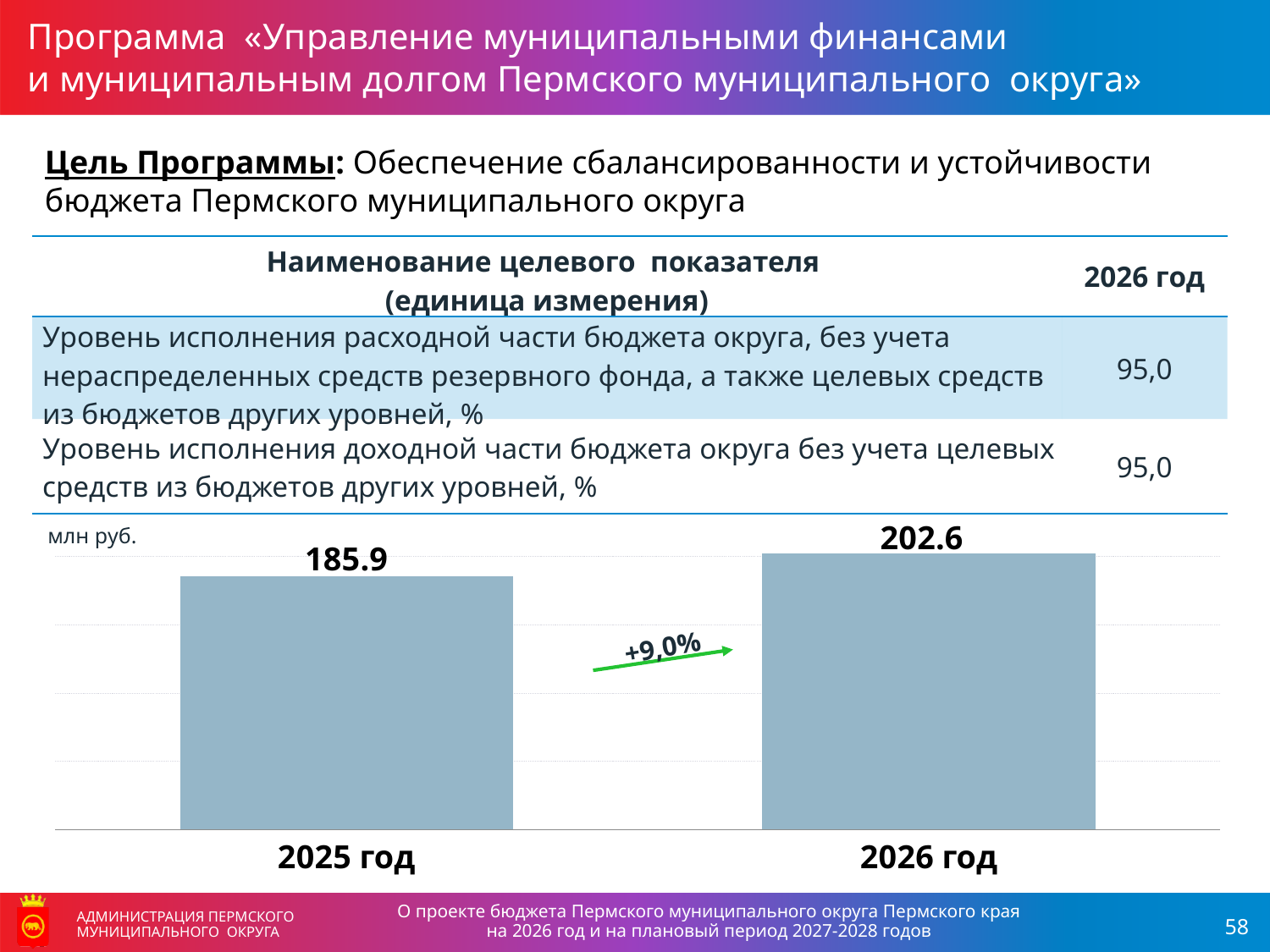
Which year has the lowest value in the bar chart? 2025 год Which year has the highest value in the bar chart? 2026 год What is the difference between the values for 2026 год and 2025 год in the bar chart? 16.7 What kind of chart is shown on the slide? bar chart What is the value for 2025 год in the bar chart? 185.9 What unit of measurement is indicated for the values in the bar chart? млн руб. What is the value for 2026 год in the bar chart? 202.6 How many bars are shown in the chart? 2 Which is larger in the bar chart: the value for 2025 год or the value for 2026 год? 2026 год Do the values in the chart rise or fall from 2025 год to 2026 год? rise What percentage change is annotated between the two bars in the chart? +9,0%